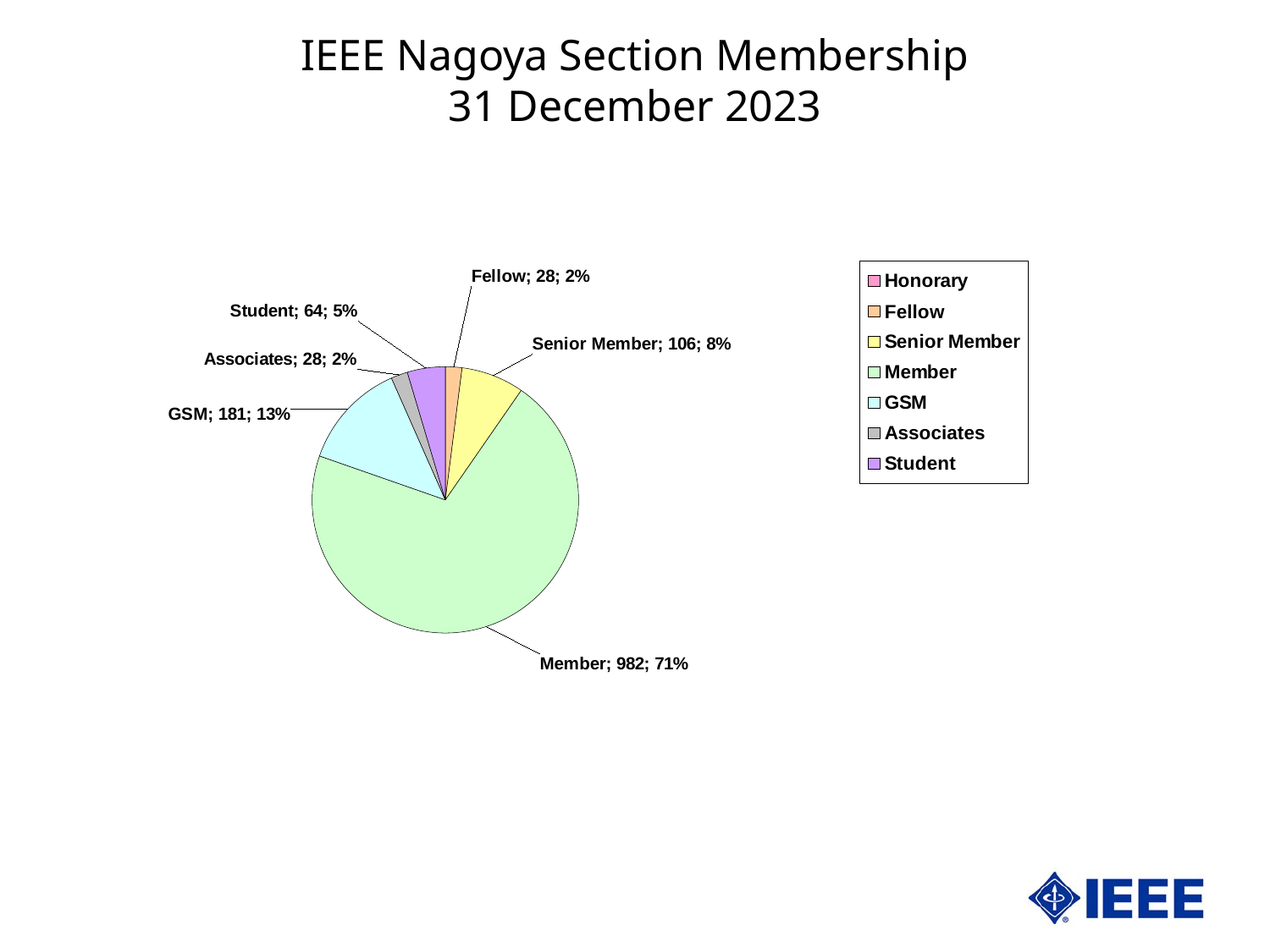
What share of the pie does the Member slice represent? 71% Which category has the largest slice of the pie? Member Which is larger, the Student count or the Fellow count? Student How many entries does the legend list? 7 What percentage of the membership is Associates? 2% What kind of chart is shown on the slide? pie chart How many Student members are shown? 64 How many members are in the Member category? 982 What is the difference between the GSM count and the Senior Member count? 75 How many Senior Members are shown? 106 What percentage of the membership is GSM? 13% What is the title of the slide? IEEE Nagoya Section Membership 31 December 2023